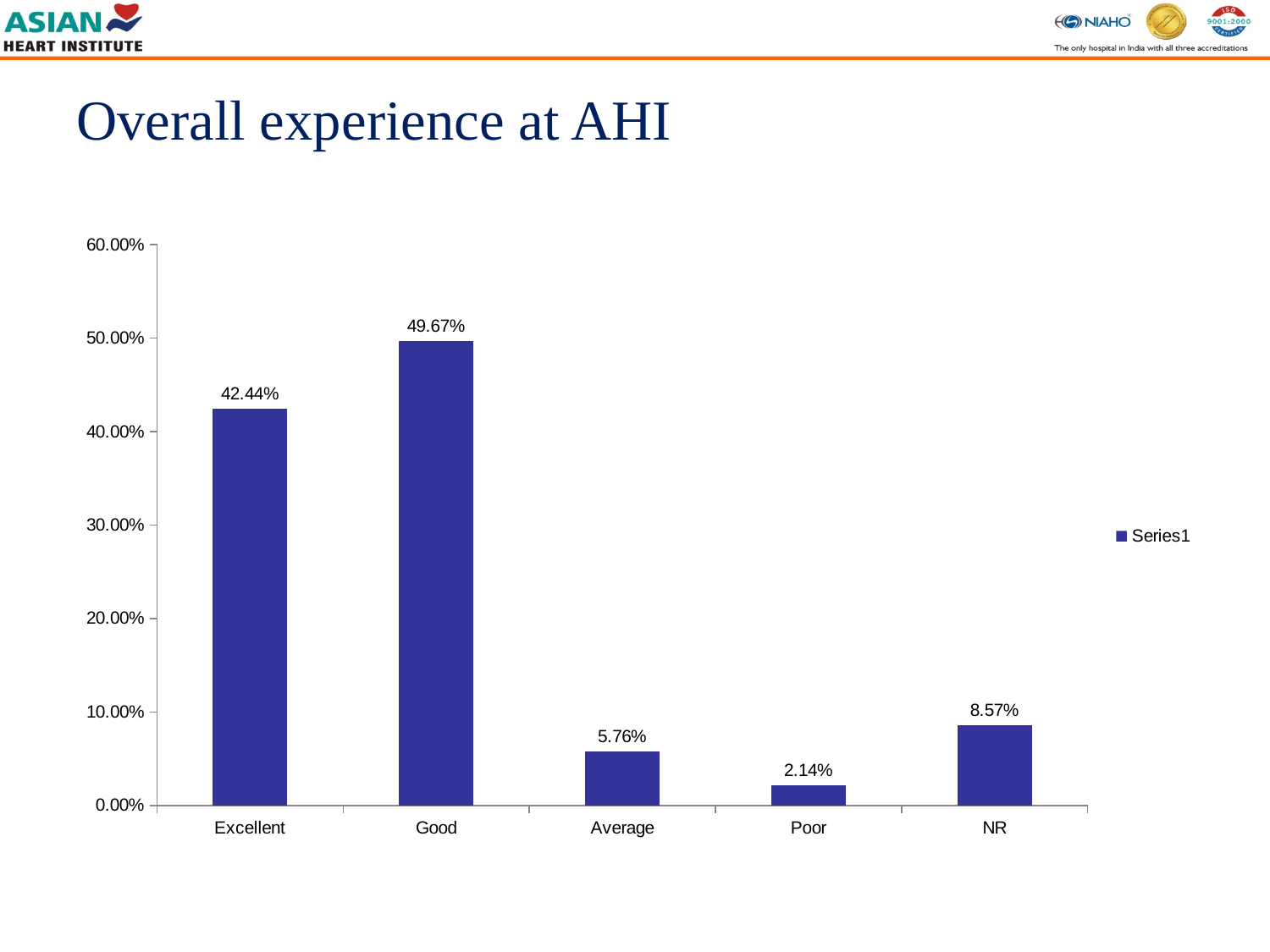
Is the value for Excellent greater or less than 40.00%? greater What is the value for NR? 8.57% What kind of chart is shown on the slide? Bar chart Which category has the highest value? Good Which category has the lowest value? Poor What is the value for Excellent? 42.44% How many categories are shown on the x axis? 5 What is the title of the slide? Overall experience at AHI What is the difference between the values for Good and Excellent? 7.23% What is the value for Good? 49.67% Which is larger, the value for Average or the value for NR? NR What is the value for Poor? 2.14%